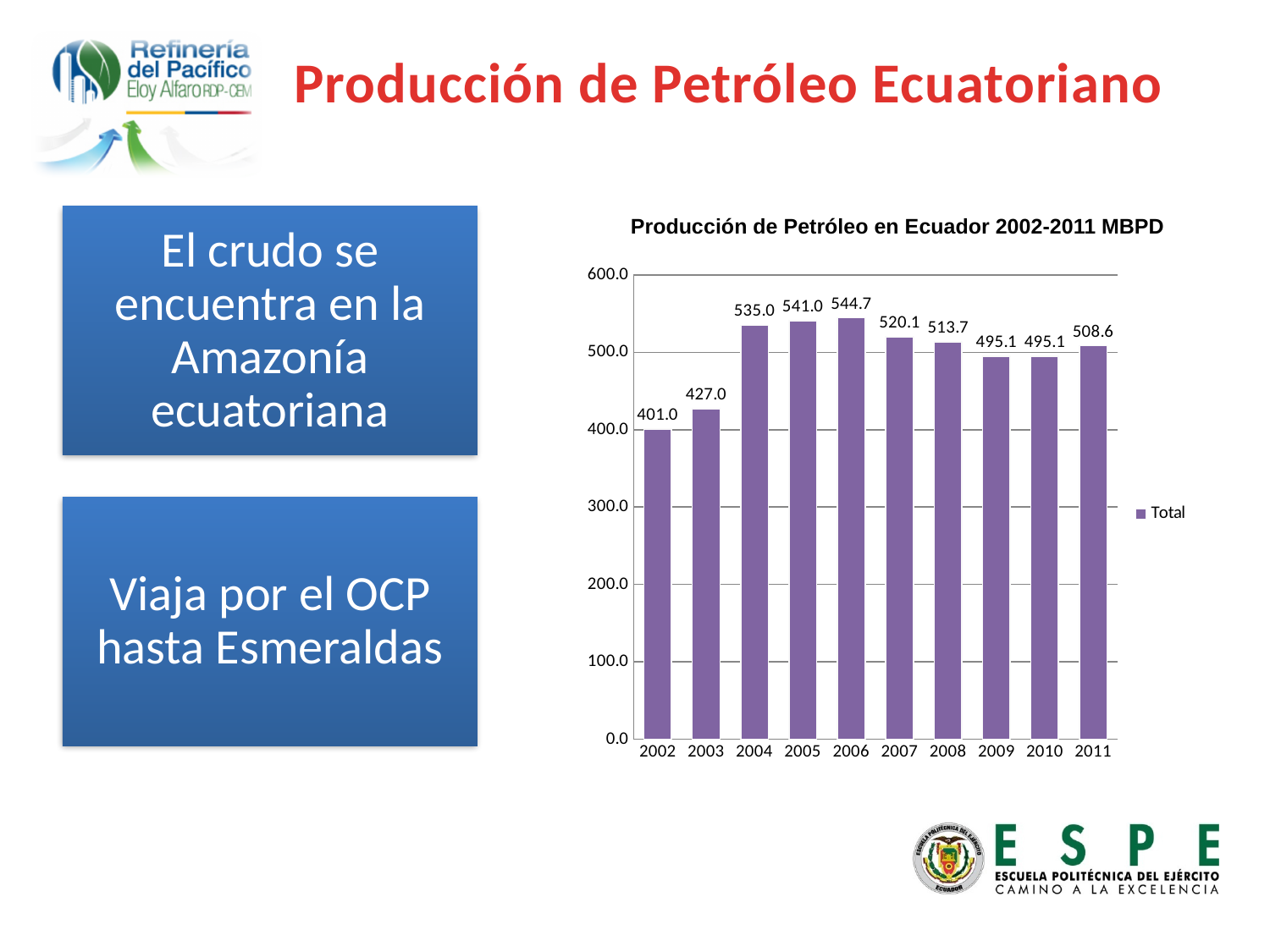
Which is larger, the value for 2007 or the value for 2011? 2007 How many years are shown on the x axis? 10 What is the value for 2002? 401.0 Is the value for 2003 greater or less than 500.0? less Which year has the highest value? 2006 What is the value for 2006? 544.7 How many series does the legend list? 1 What kind of chart is shown? bar chart What is the difference between the values for 2006 and 2002? 143.7 Which year has the lowest value? 2002 What is the value for 2009? 495.1 What is the difference between the values for 2004 and 2003? 108.0